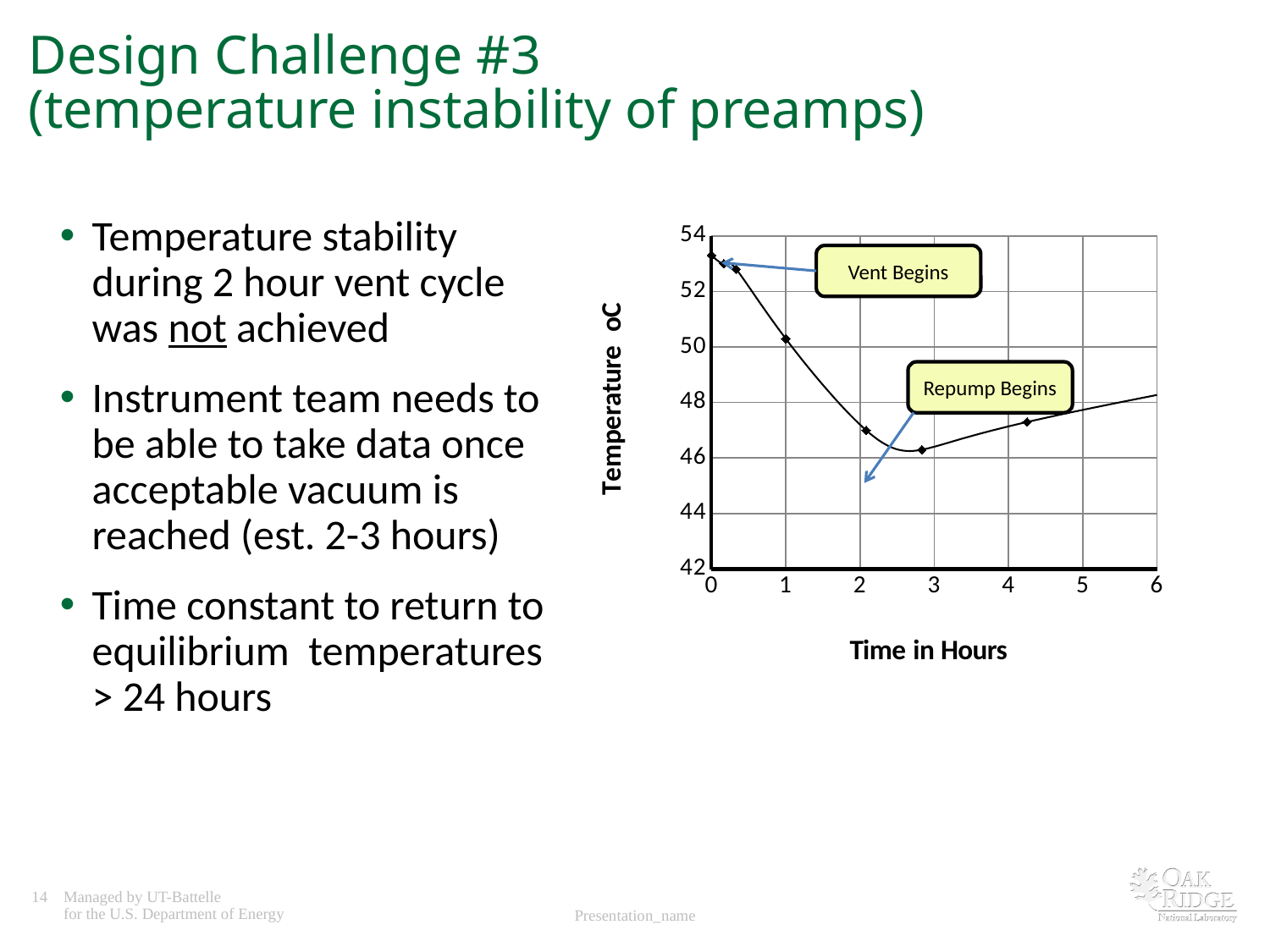
What two events are labelled by the callout boxes on the chart? Vent Begins and Repump Begins Is the temperature at 0 hours greater or less than 52? greater Does the temperature rise or fall between 0 and 2 hours? fall At what time is the temperature highest? 0 hours Does the temperature rise or fall between 3 and 6 hours? rise Is the temperature at 3 hours greater or less than 48? less What kind of chart is shown on the slide? line chart Is the temperature at 4 hours greater or less than 46? greater Which is higher, the temperature at 1 hour or at 4 hours? 1 hour What is the title of the x axis of the chart? Time in Hours